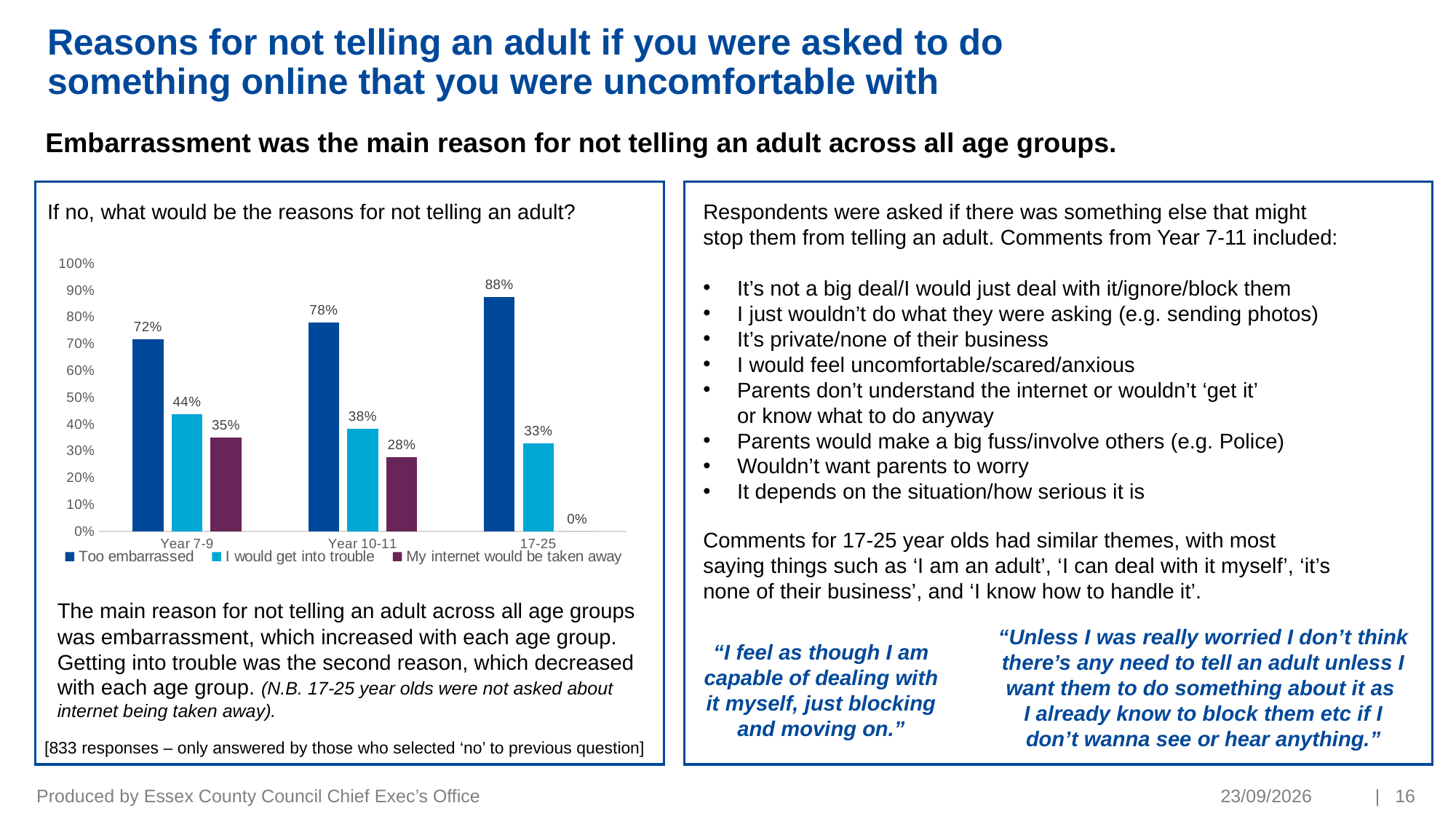
Which age group has the lowest value for 'I would get into trouble'? 17-25 What percentage of Year 7-9 respondents gave 'Too embarrassed' as a reason for not telling an adult? 72% Which age group has the highest value for 'Too embarrassed'? 17-25 Which is larger for Year 10-11: 'I would get into trouble' or 'My internet would be taken away'? I would get into trouble What is the value for 'I would get into trouble' in the Year 10-11 group? 38% What is the difference between the 'Too embarrassed' values for 17-25 and Year 7-9? 16 percentage points What is the value for 'I would get into trouble' in the 17-25 group? 33% What type of chart is used to show the reasons for not telling an adult? Bar chart How many series does the chart legend list? 3 How many age groups are shown on the x axis of the chart? 3 Does the 'Too embarrassed' value rise or fall across the age groups from Year 7-9 to 17-25? Rise What is the value for 'My internet would be taken away' in the Year 7-9 group? 35%